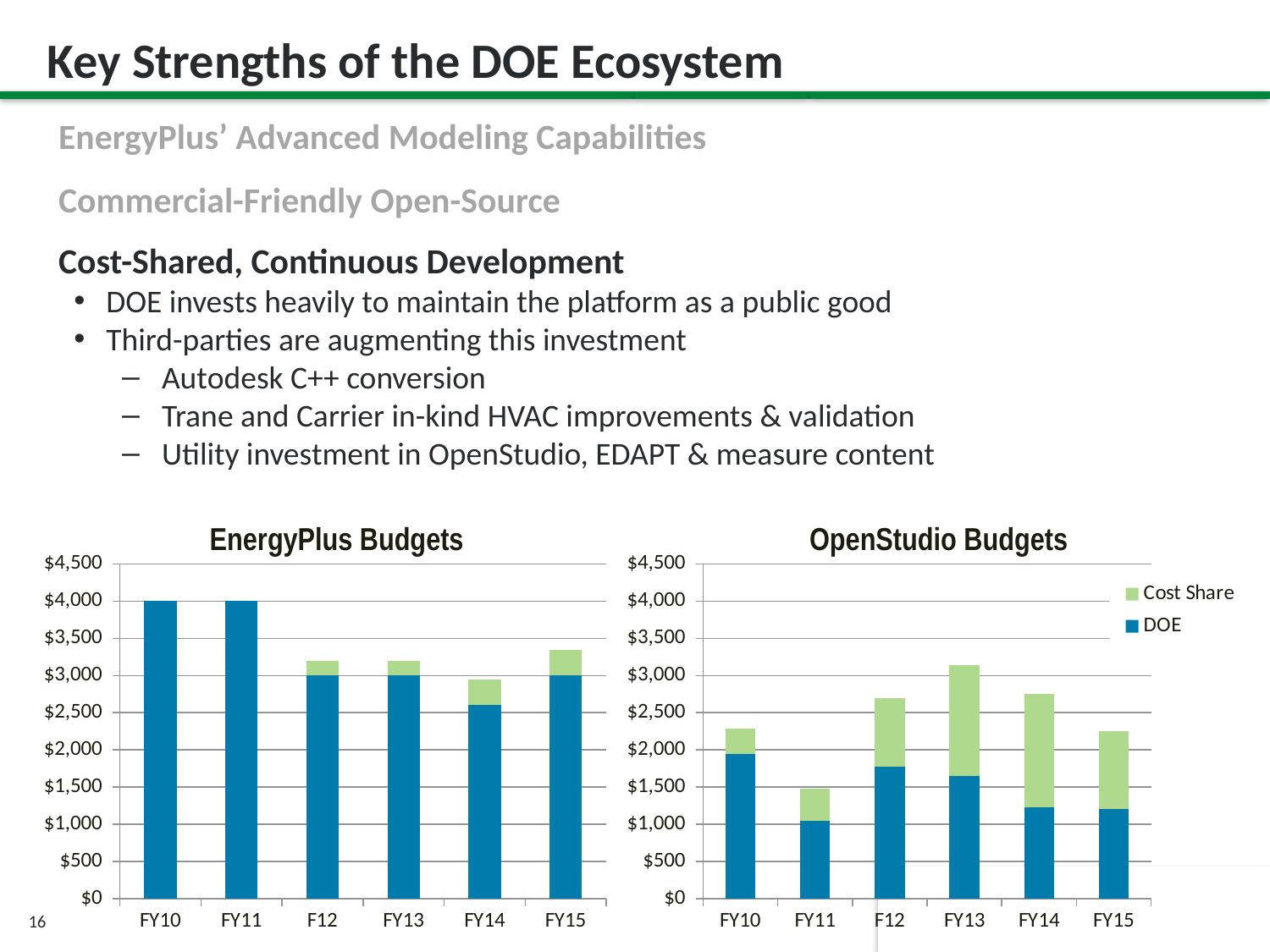
In the OpenStudio Budgets chart, is the DOE value for FY10 greater or less than $1,500? greater In the OpenStudio Budgets chart, which fiscal year has the highest total bar? FY13 How many fiscal years are shown on the x axis of the OpenStudio Budgets chart? 6 In the OpenStudio Budgets chart, which is larger, the Cost Share portion for FY13 or for FY10? FY13 How many series does the legend on the OpenStudio Budgets chart list? 2 In the EnergyPlus Budgets chart, what is the DOE value for F12? $3,000 In the OpenStudio Budgets chart, which fiscal year has the lowest total bar? FY11 In the EnergyPlus Budgets chart, which fiscal year has the lowest total bar? FY14 What kind of chart is the EnergyPlus Budgets chart? Stacked bar chart In the EnergyPlus Budgets chart, what is the DOE value for FY10? $4,000 In the OpenStudio Budgets chart, which colour represents the Cost Share series? Green